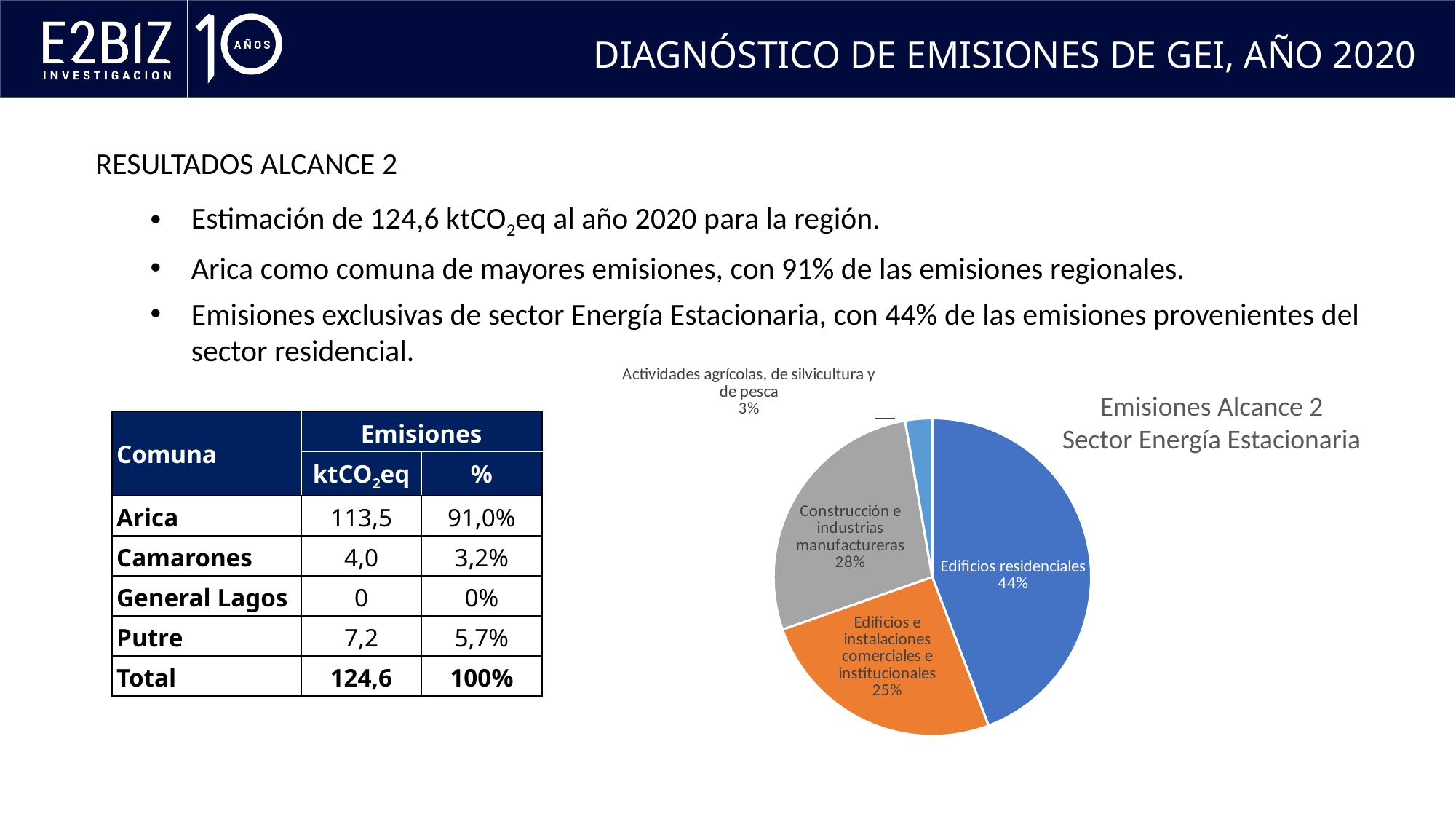
Which is larger: the share for Edificios residenciales or the share for Edificios e instalaciones comerciales e institucionales? Edificios residenciales Which labelled slice of the pie chart is the largest? Edificios residenciales What type of chart is shown on the slide? pie chart What share of the pie does Edificios e instalaciones comerciales e institucionales represent? 25% What is the title of the pie chart? Emisiones Alcance 2 Sector Energía Estacionaria What is the difference in percentage points between Edificios residenciales and Construcción e industrias manufactureras? 16 What share of the pie does Edificios residenciales represent? 44% What is the difference in percentage points between Construcción e industrias manufactureras and Edificios e instalaciones comerciales e institucionales? 3 What colour is the Edificios residenciales slice in the pie chart? blue What share of the pie does Construcción e industrias manufactureras represent? 28% Which labelled slice of the pie chart is the smallest? Actividades agrícolas, de silvicultura y de pesca